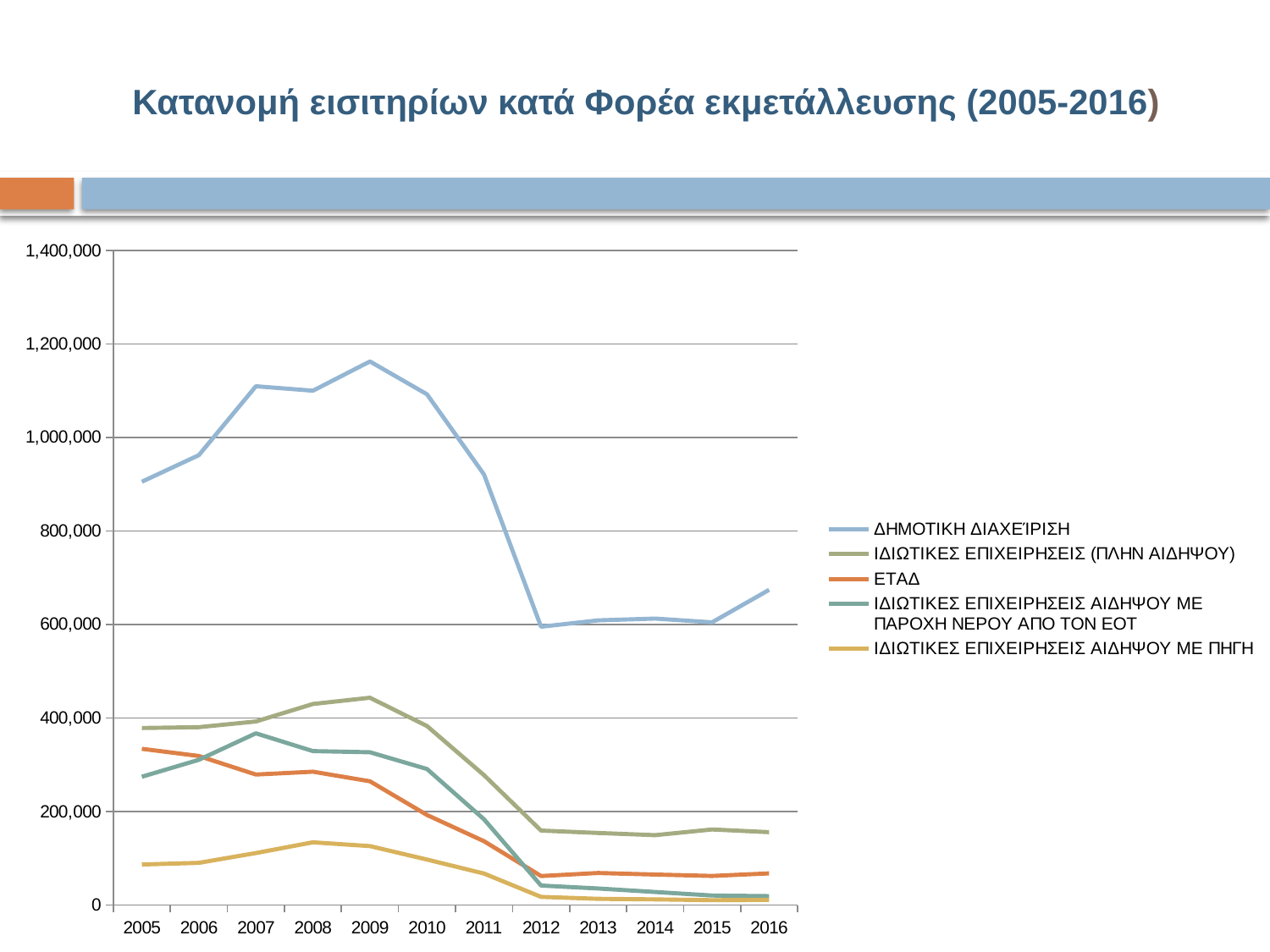
How many series does the legend list? 5 Is the value for ΙΔΙΩΤΙΚΕΣ ΕΠΙΧΕΙΡΗΣΕΙΣ (ΠΛΗΝ ΑΙΔΗΨΟΥ) in 2009 greater or less than 400,000? greater What kind of chart is shown on the slide? Line chart Is the value for ΔΗΜΟΤΙΚΗ ΔΙΑΧΕΊΡΙΣΗ in 2009 greater or less than 1,000,000? greater Is the value for ΔΗΜΟΤΙΚΗ ΔΙΑΧΕΊΡΙΣΗ in 2012 greater or less than 800,000? less Does the ΔΗΜΟΤΙΚΗ ΔΙΑΧΕΊΡΙΣΗ series rise or fall between 2009 and 2012? Fall What is the title of the slide? Κατανομή εισιτηρίων κατά Φορέα εκμετάλλευσης (2005-2016) Which series has the highest value in 2009? ΔΗΜΟΤΙΚΗ ΔΙΑΧΕΊΡΙΣΗ In 2005, which is larger: ΕΤΑΔ or ΙΔΙΩΤΙΚΕΣ ΕΠΙΧΕΙΡΗΣΕΙΣ ΑΙΔΗΨΟΥ ΜΕ ΠΑΡΟΧΗ ΝΕΡΟΥ ΑΠΟ ΤΟΝ ΕΟΤ? ΕΤΑΔ How many years are shown on the x axis? 12 Which series has the lowest value in 2005? ΙΔΙΩΤΙΚΕΣ ΕΠΙΧΕΙΡΗΣΕΙΣ ΑΙΔΗΨΟΥ ΜΕ ΠΗΓΗ In which year does the ΔΗΜΟΤΙΚΗ ΔΙΑΧΕΊΡΙΣΗ series reach its highest value? 2009